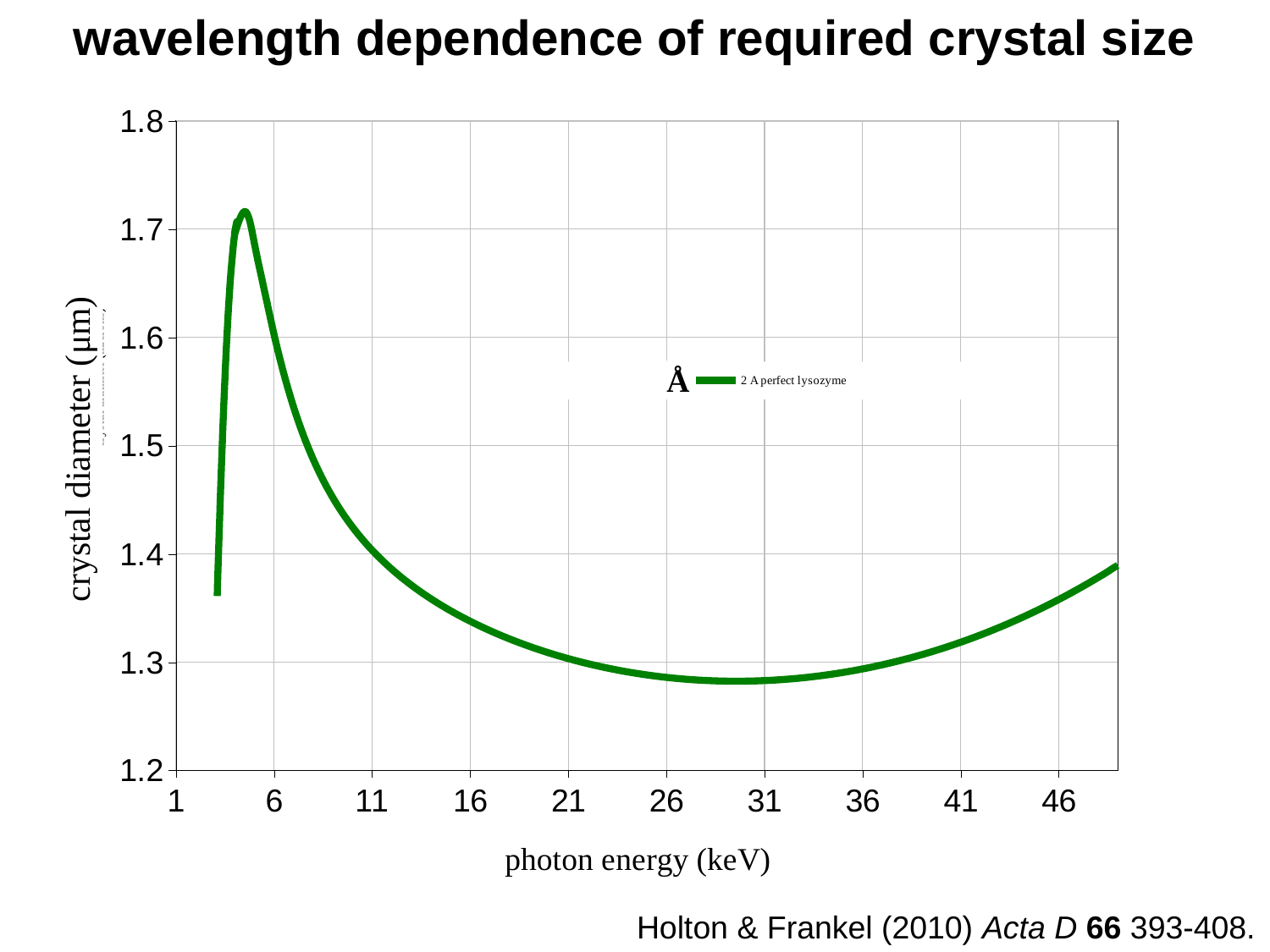
How many series does the legend list? 1 What is the title of the chart? wavelength dependence of required crystal size Is the crystal diameter at a photon energy of 46 keV greater or less than 1.4 μm? less What kind of chart is shown on the slide? line chart What series name is shown in the legend? 2 A perfect lysozyme Is the crystal diameter at a photon energy of 16 keV greater or less than 1.4 μm? less Is the crystal diameter at a photon energy of 16 keV greater or less than 1.3 μm? greater Does the crystal diameter rise or fall as photon energy increases from 6 keV to 26 keV? fall Does the crystal diameter rise or fall as photon energy increases from 31 keV to 46 keV? rise Which is larger, the crystal diameter at 11 keV or at 26 keV? 11 keV